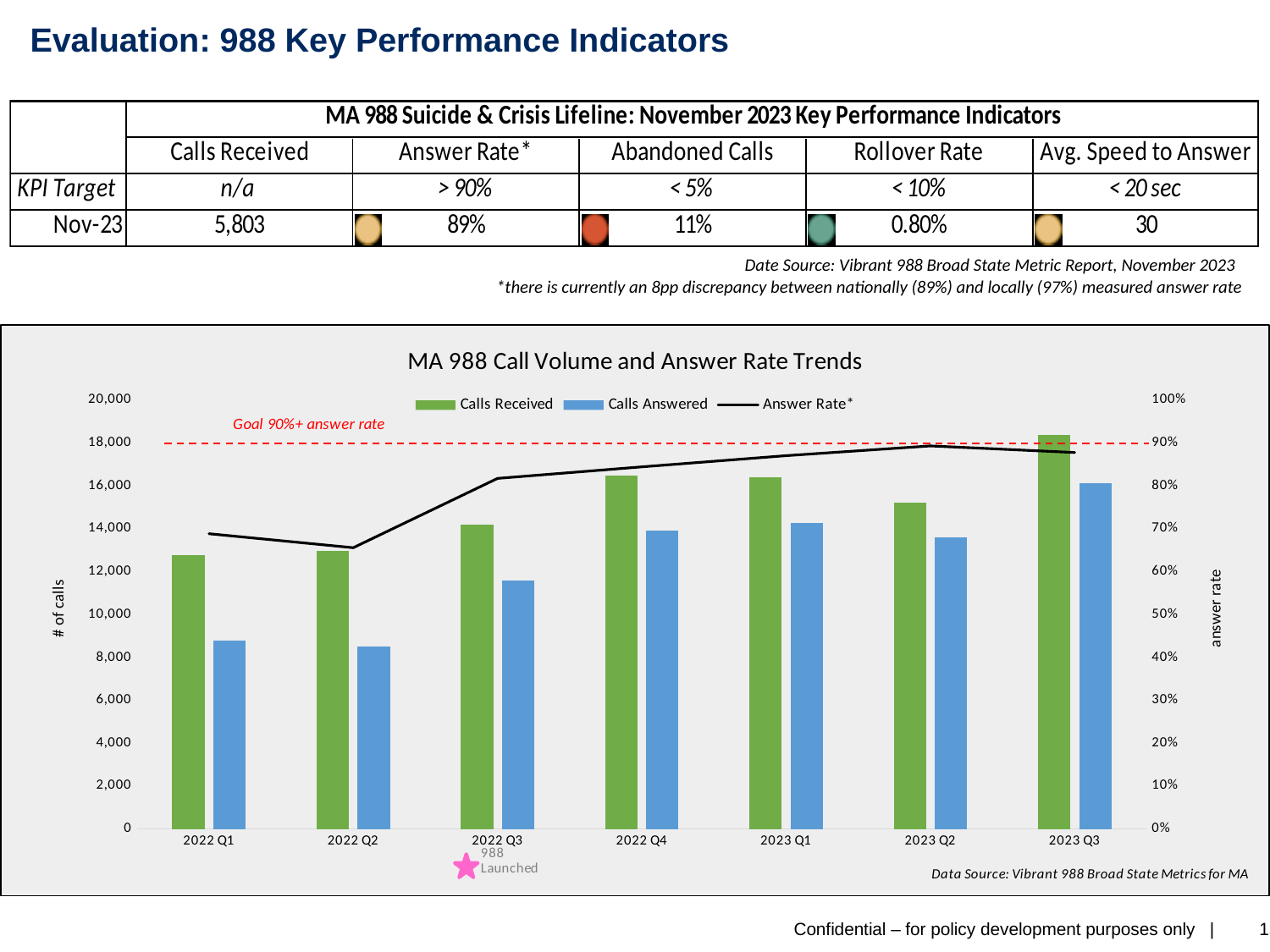
How many quarters are shown on the x axis of the chart? 7 In which quarter is the Calls Received bar highest? 2023 Q3 Do Calls Received rise or fall from 2022 Q1 to 2022 Q4? rise How many series does the chart legend list? 3 What kind of chart is used to show Calls Received and Calls Answered? bar chart What answer rate goal does the dashed red line on the chart mark? Goal 90%+ answer rate In which quarter is the Calls Answered bar highest? 2023 Q3 Is the value for Calls Received in 2022 Q1 greater or less than 12,000? greater Is the Answer Rate in 2022 Q1 greater or less than 80%? less Is the value for Calls Answered in 2022 Q2 greater or less than 10,000? less Which is larger: Calls Received in 2022 Q4 or Calls Received in 2023 Q2? 2022 Q4 What is the title of the chart on the slide? MA 988 Call Volume and Answer Rate Trends